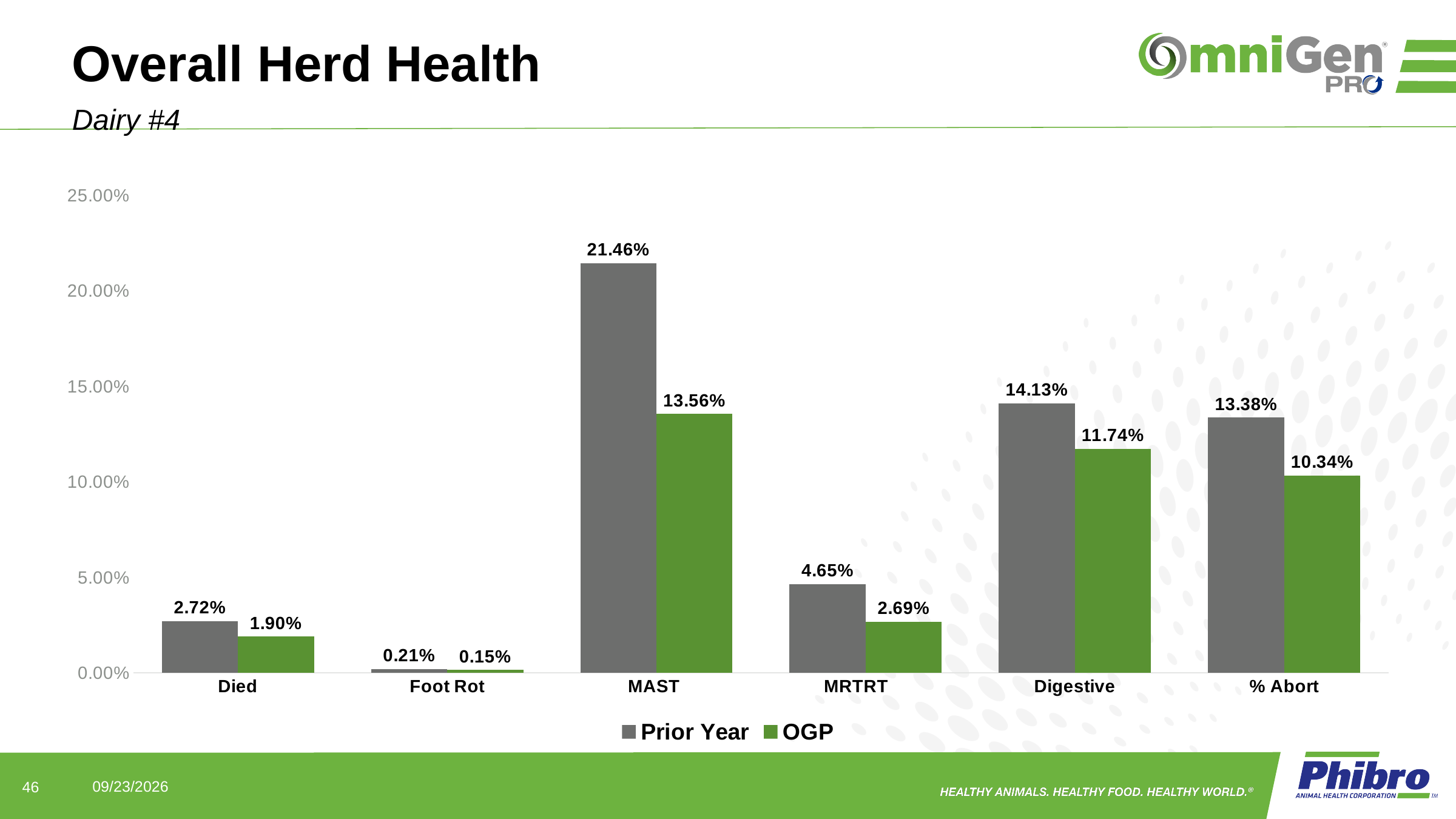
Which category has the highest Prior Year value? MAST What is the Prior Year value for MAST? 21.46% What is the difference between the Prior Year and OGP values for % Abort? 3.04% How many series does the legend list? 2 What kind of chart is shown on the slide? bar chart What is the OGP value for Foot Rot? 0.15% What is the OGP value for Digestive? 11.74% How many categories are shown on the x axis? 6 Is the OGP value for Digestive greater or less than 10.00%? greater Which is larger for MRTRT, the Prior Year value or the OGP value? Prior Year What is the difference between the Prior Year and OGP values for MAST? 7.90% Which category has the lowest OGP value? Foot Rot